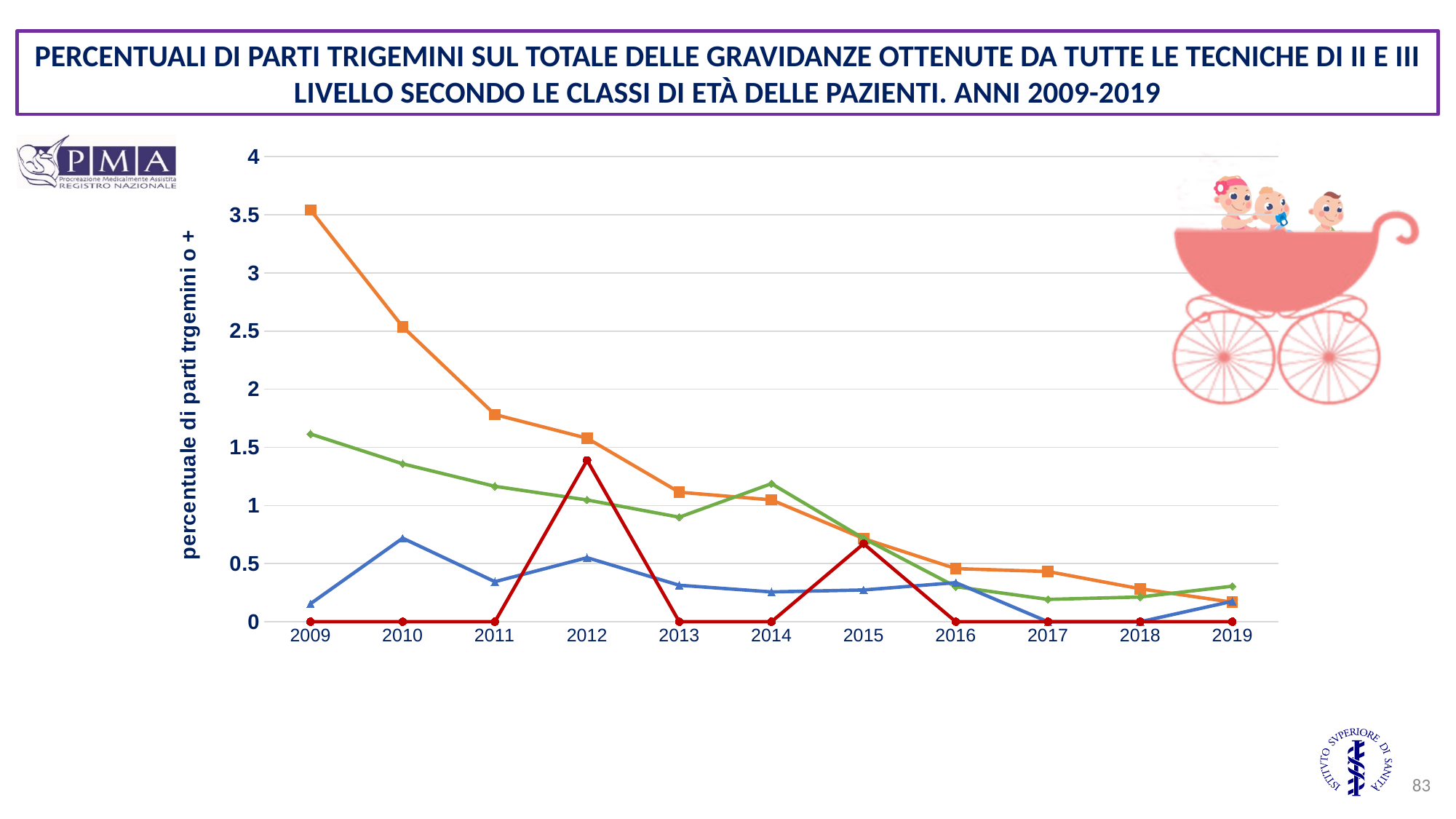
In which year does the orange line reach its highest value? 2009 What is the value of the red line in 2013? 0 Is the value of the orange line in 2010 greater or less than 2? greater Is the value of the blue line in 2010 greater or less than 0.5? greater What kind of chart is shown on the slide? line chart What is the label of the y axis? percentuale di parti trgemini o + Does the orange line rise or fall from 2009 to 2019? fall In 2009, which line has the larger value, the orange line or the green line? orange Is the value of the red line in 2012 greater or less than 1? greater How many years are shown along the x axis of the chart? 11 How many lines are plotted in the chart? 4